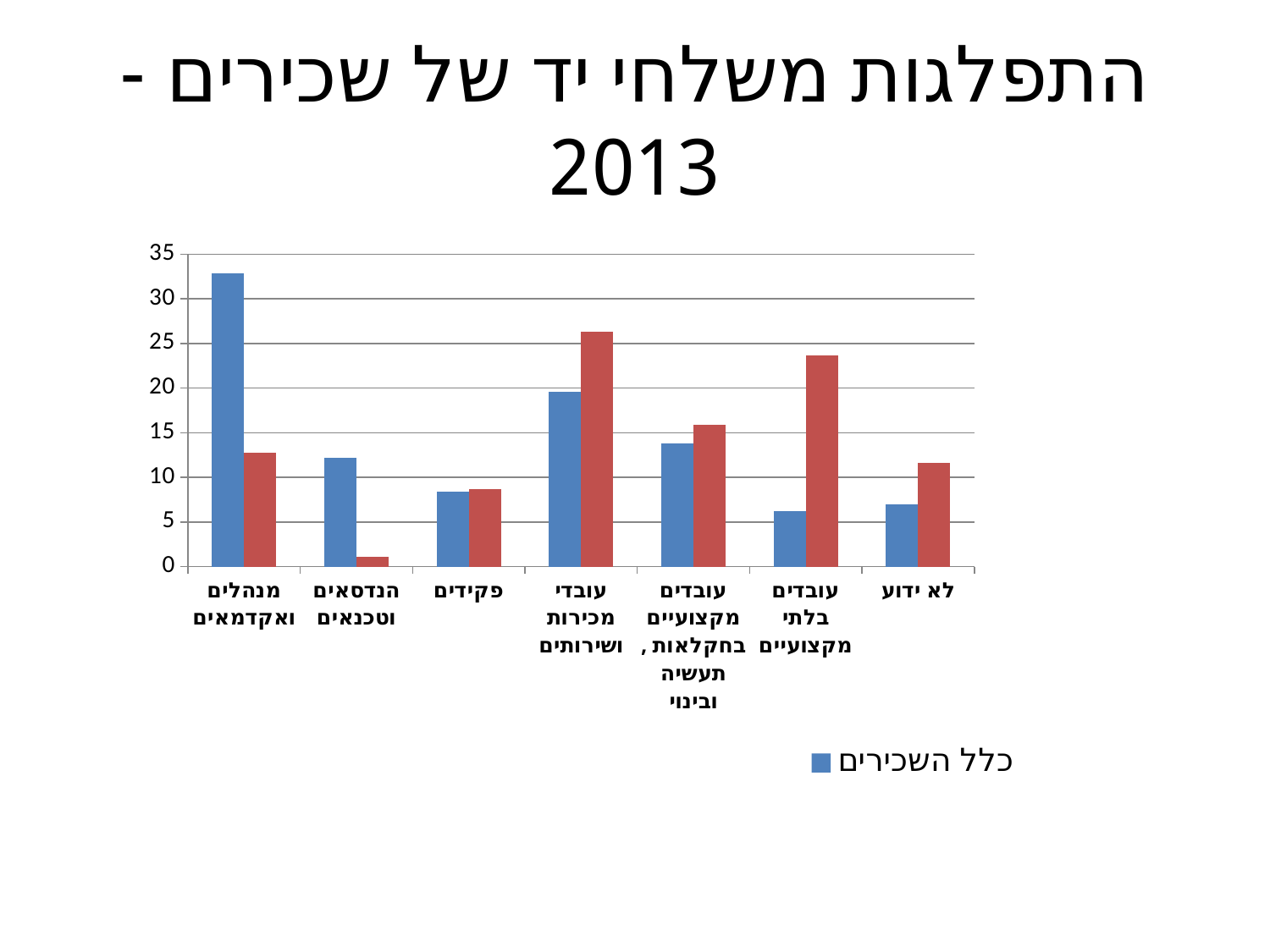
How many occupation categories are shown on the x axis? 7 How many series does the legend list? 1 Which category has the lowest value in the red series? הנדסאים וטכנאים What is the legend entry shown for the blue series? כלל השכירים Which category has the highest value in the blue series (כלל השכירים)? מנהלים ואקדמאים Is the blue (כלל השכירים) value for פקידים greater or less than 10? less Is the red value for הנדסאים וטכנאים greater or less than 5? less What is the title of the chart slide? התפלגות משלחי יד של שכירים - 2013 Is the blue (כלל השכירים) value for מנהלים ואקדמאים greater or less than 30? greater Which category has the highest value in the red series? עובדי מכירות ושירותים What kind of chart is shown on the slide? bar chart For עובדים בלתי מקצועיים, which bar is larger, the blue one or the red one? the red one